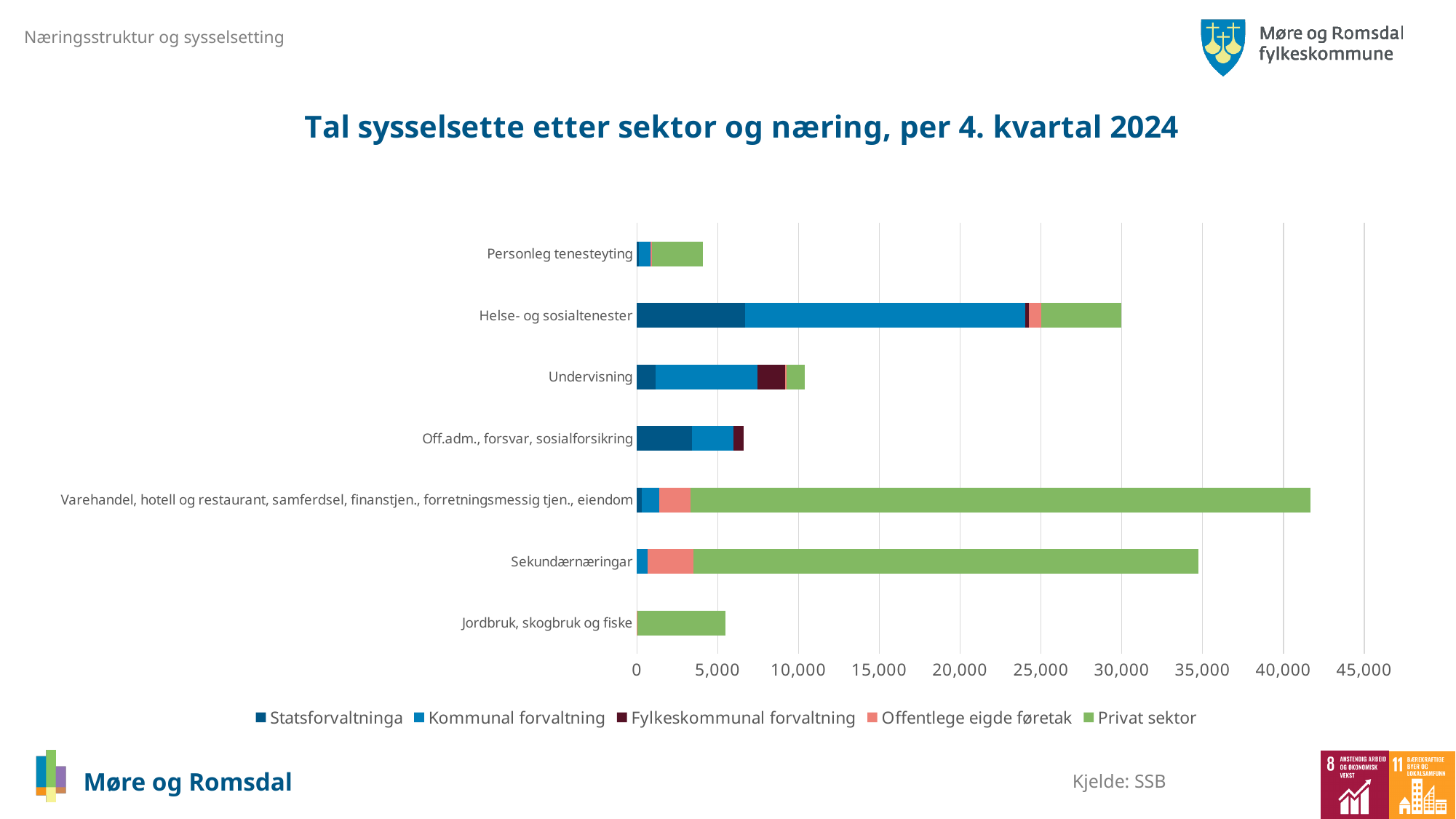
Is the total value for Helse- og sosialtenester greater or less than 25,000? greater Is the total value for Sekundærnæringar greater or less than 30,000? greater What is the title of the chart? Tal sysselsette etter sektor og næring, per 4. kvartal 2024 How many categories (næringar) are plotted on the y axis? 7 How many series does the legend list? 5 Which colour represents Privat sektor in the legend? Green Is the total value for Varehandel, hotell og restaurant, samferdsel, finanstjen., forretningsmessig tjen., eiendom greater or less than 40,000? greater Which has a larger total bar, Helse- og sosialtenester or Undervisning? Helse- og sosialtenester Which category has the shortest total bar? Personleg tenesteyting What kind of chart is shown on the slide? Stacked bar chart Which category has the longest total bar? Varehandel, hotell og restaurant, samferdsel, finanstjen., forretningsmessig tjen., eiendom